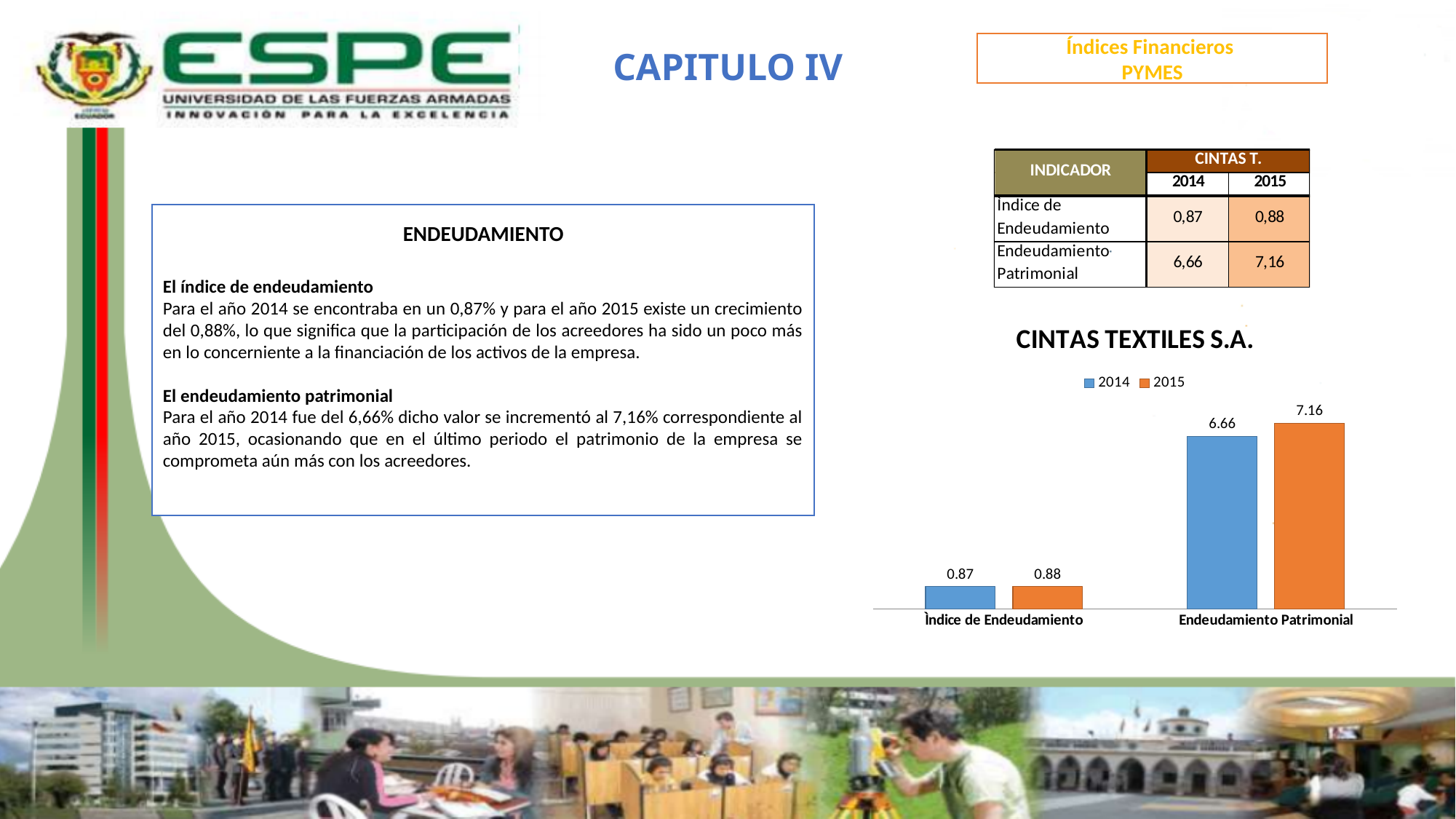
What kind of chart is shown on the slide? Bar chart What is the value for 2014 for Endeudamiento Patrimonial in the chart? 6.66 What is the difference between the 2015 and 2014 values for Endeudamiento Patrimonial? 0.50 Which category has the highest 2015 value in the chart? Endeudamiento Patrimonial Which category has the lowest 2014 value in the chart? Ìndice de Endeudamiento For Endeudamiento Patrimonial, which year has the larger value, 2014 or 2015? 2015 How many categories are shown on the x axis of the chart? 2 What is the value for 2015 for Ìndice de Endeudamiento in the chart? 0.88 What is the title of the chart? CINTAS TEXTILES S.A. How many series does the chart legend list? 2 What is the value for 2015 for Endeudamiento Patrimonial in the chart? 7.16 What is the value for 2014 for Ìndice de Endeudamiento in the chart? 0.87